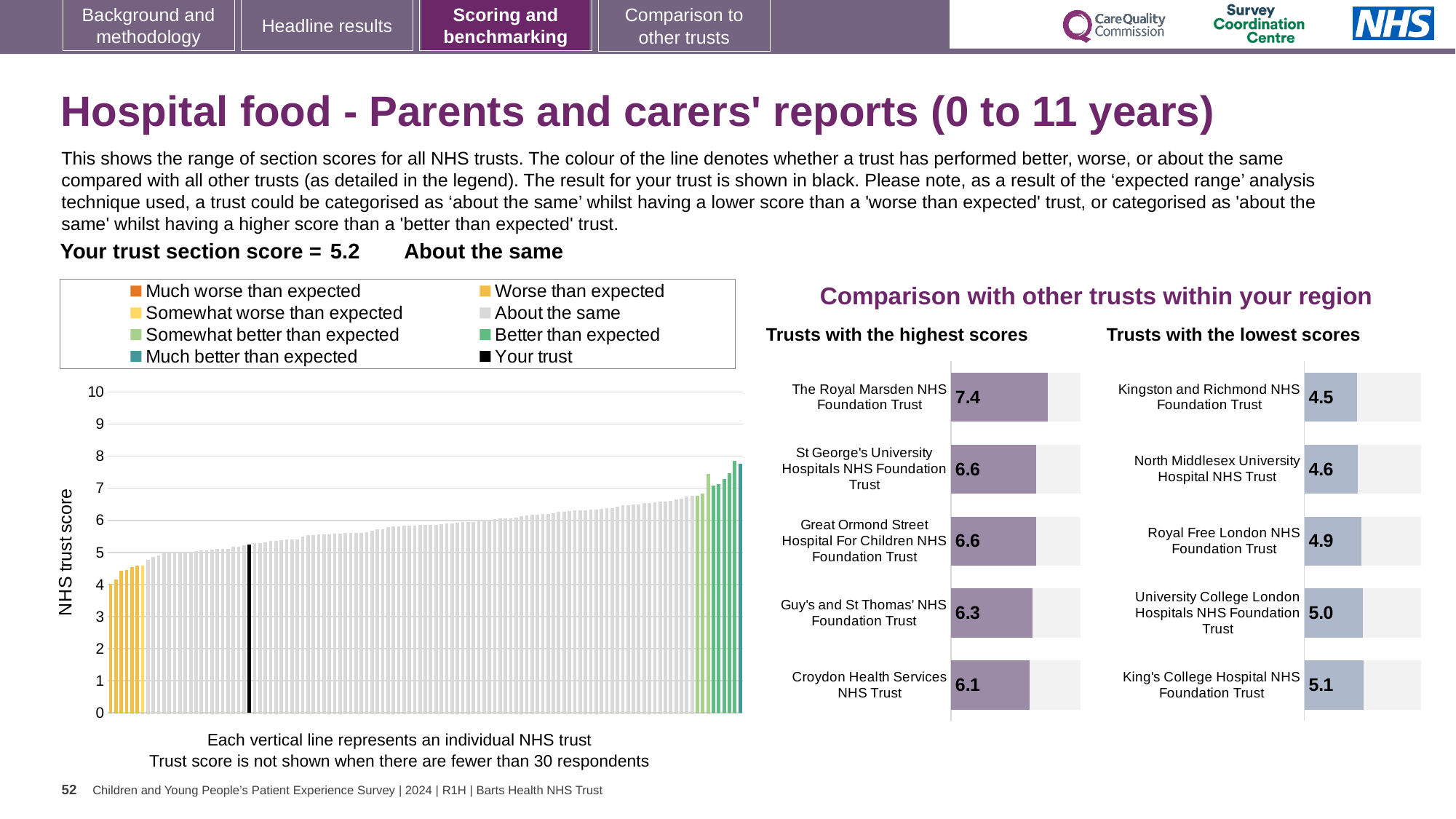
On the 'Trusts with the lowest scores' chart, which has the higher score: Royal Free London NHS Foundation Trust or North Middlesex University Hospital NHS Trust? Royal Free London NHS Foundation Trust On the 'Trusts with the highest scores' chart, what is the score for The Royal Marsden NHS Foundation Trust? 7.4 On the NHS trust score chart on the left, what is the section score for your trust (the black bar)? 5.2 How many entries does the legend above the NHS trust score chart list? 8 On the 'Trusts with the highest scores' chart, how many trusts are shown? 5 On the NHS trust score chart on the left, is the value of the tallest bar greater or less than 7? greater On the 'Trusts with the highest scores' chart, which trust has the lowest score? Croydon Health Services NHS Trust On the 'Trusts with the highest scores' chart, what is the difference between the scores of The Royal Marsden NHS Foundation Trust and Croydon Health Services NHS Trust? 1.3 On the 'Trusts with the lowest scores' chart, which trust has the lowest score? Kingston and Richmond NHS Foundation Trust On the 'Trusts with the lowest scores' chart, what is the difference between the scores of King's College Hospital NHS Foundation Trust and Kingston and Richmond NHS Foundation Trust? 0.6 On the 'Trusts with the lowest scores' chart, what is the score for Royal Free London NHS Foundation Trust? 4.9 On the NHS trust score chart on the left, do the bar values rise or fall from left to right? rise